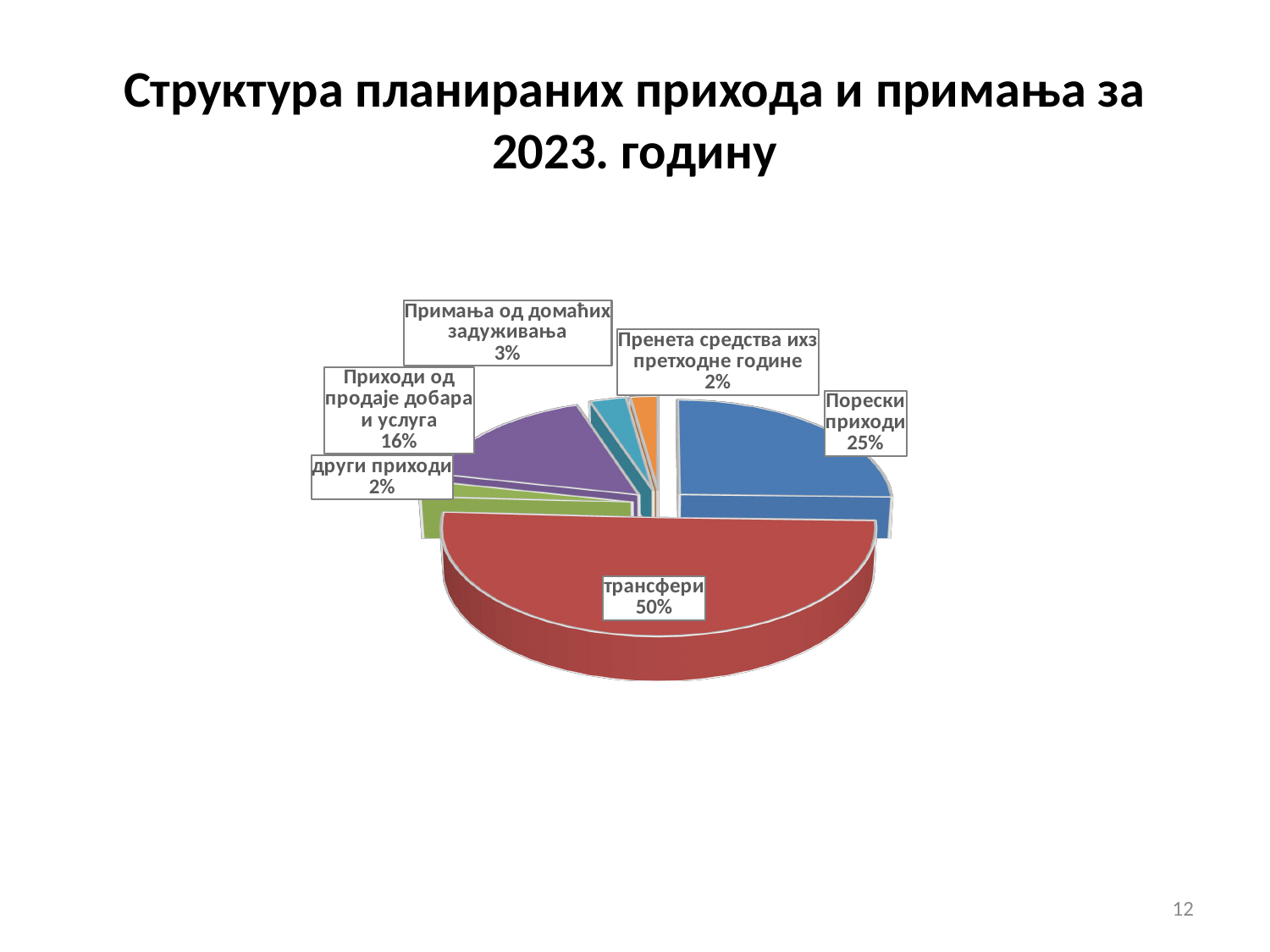
What share of the pie does Примања од домаћих задуживања account for? 3% What share of the pie does Приходи од продаје добара и услуга account for? 16% Which is larger, Порески приходи or Приходи од продаје добара и услуга? Порески приходи What colour is the трансфери slice? red What is the difference in percentage points between трансфери and Порески приходи? 25 What share of the pie does Порески приходи account for? 25% How many slices does the pie chart have? 6 What is the difference in percentage points between Приходи од продаје добара и услуга and Примања од домаћих задуживања? 13 What kind of chart is shown on the slide? pie chart Which category has the largest slice of the pie? трансфери